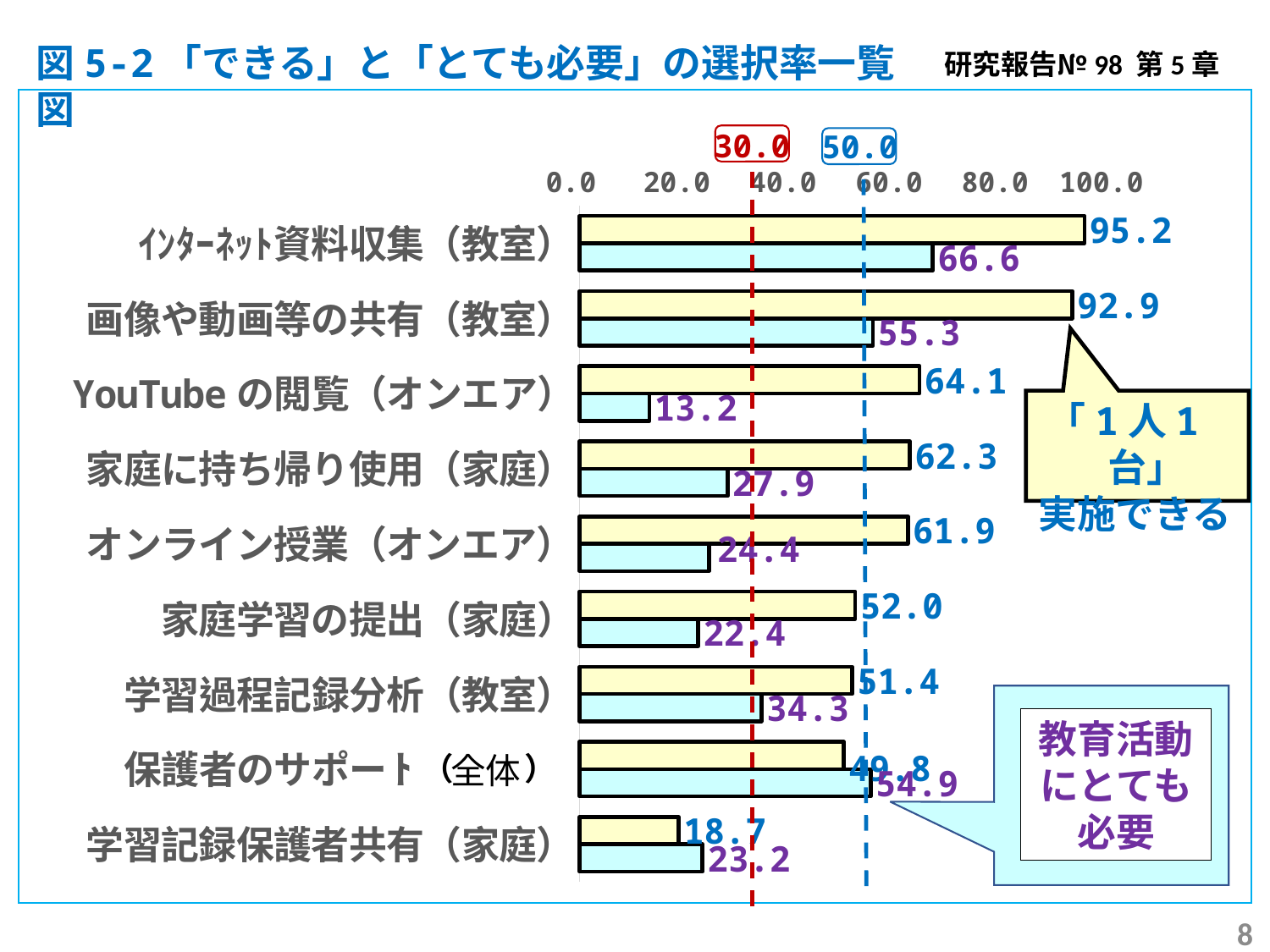
Is the 「できる」 value for 家庭学習の提出（家庭） greater or less than 50.0? greater What is the difference between the 「できる」 and 「とても必要」 values for 画像や動画等の共有（教室）? 37.6 What is the 「できる」 (yellow bar) value for インターネット資料収集（教室）? 95.2 What type of chart is shown on the slide? bar chart For 学習記録保護者共有（家庭）, which is larger: the 「できる」 value or the 「とても必要」 value? 「とても必要」 (23.2) What is the 「とても必要」 (light blue bar) value for 保護者のサポート（全体）? 54.9 What is the 「とても必要」 (light blue bar) value for YouTubeの閲覧（オンエア）? 13.2 What value does the red dashed vertical line mark on the axis? 30.0 How many categories are plotted in the chart? 9 Which category has the highest 「できる」 (yellow bar) value? インターネット資料収集（教室） Which category has the lowest 「とても必要」 (light blue bar) value? YouTubeの閲覧（オンエア） What is the 「できる」 (yellow bar) value for オンライン授業（オンエア）? 61.9